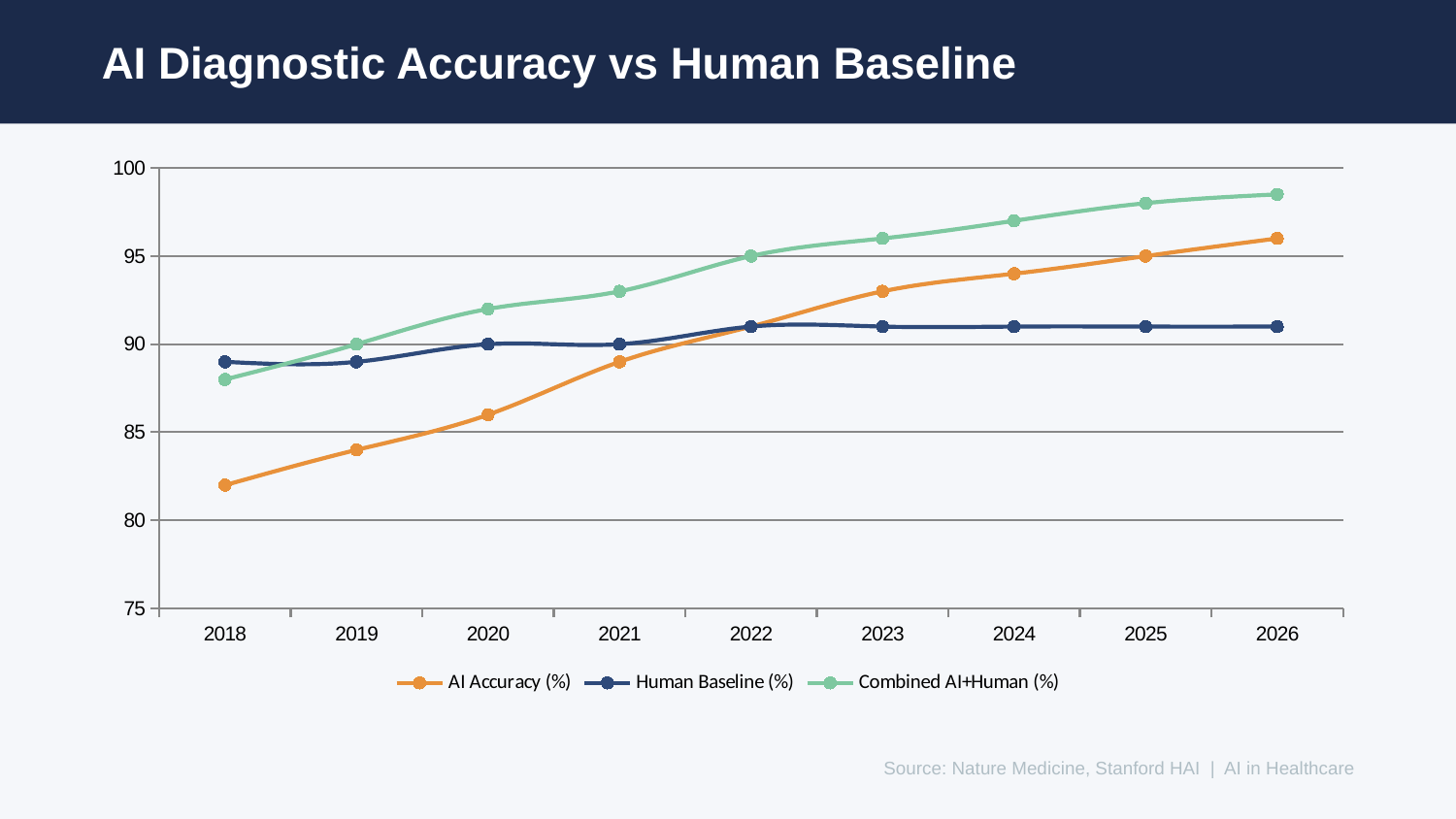
Does the AI Accuracy (%) series rise or fall from 2018 to 2026? rise Is the AI Accuracy (%) value for 2018 greater or less than 85? less What is the AI Accuracy (%) value in 2025? 95 How many series does the legend list? 3 What is the Human Baseline (%) value in 2020? 90 Which series has the lowest value in 2018? AI Accuracy (%) What is the Combined AI+Human (%) value in 2022? 95 Is the Combined AI+Human (%) value for 2026 greater or less than 95? greater How many years are shown on the x axis? 9 Which series has the highest value in 2026? Combined AI+Human (%) What kind of chart is shown on the slide? line chart Which is larger in 2021, AI Accuracy (%) or Human Baseline (%)? Human Baseline (%)